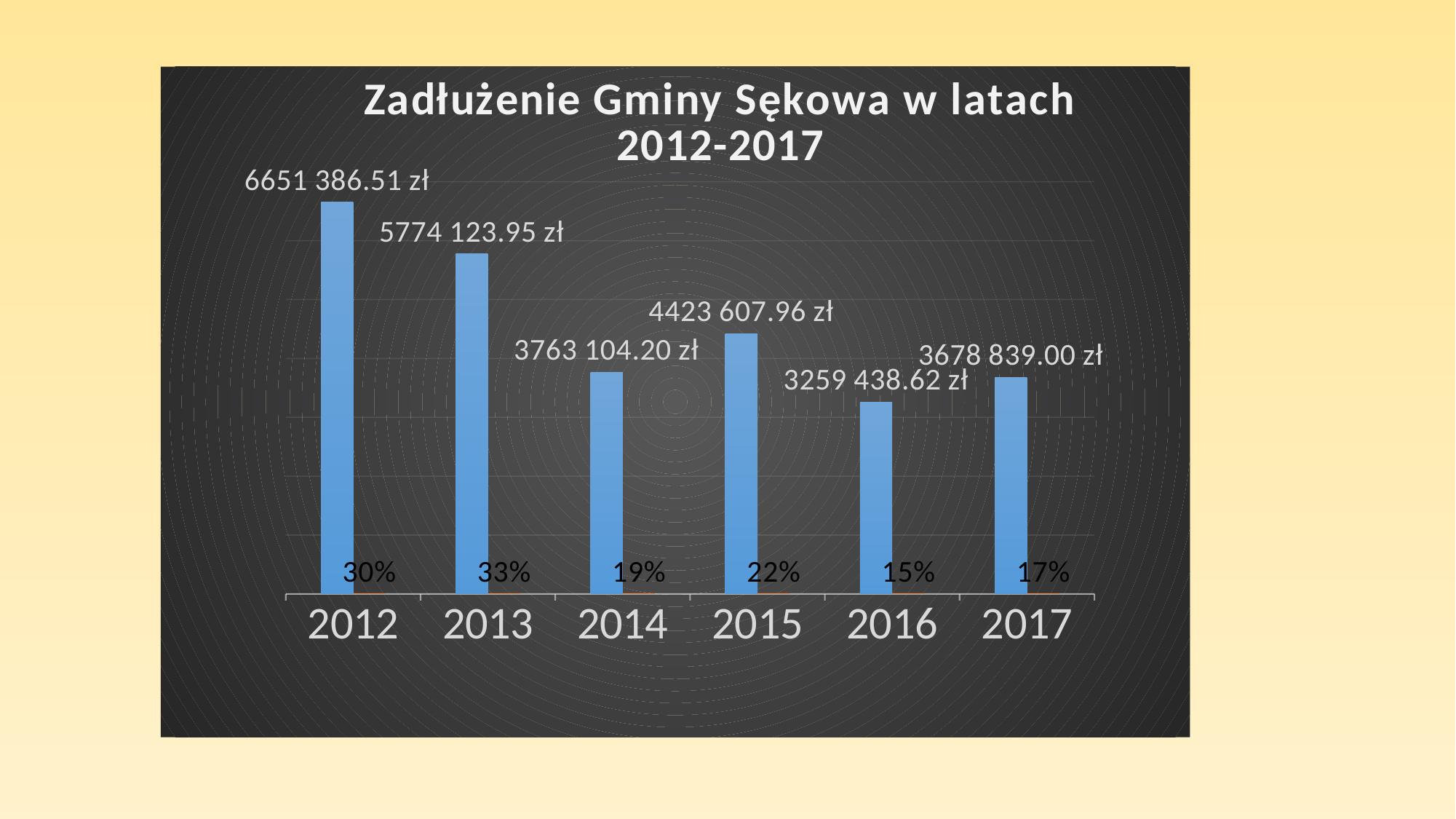
How many years are shown on the x axis? 6 What is the debt value shown for 2017? 3678 839.00 zł What kind of chart is shown on the slide? Bar chart Which year has a larger debt value, 2014 or 2015? 2015 What is the debt value shown for 2016? 3259 438.62 zł What is the difference between the debt values for 2017 and 2016? 419 400.38 zł What percentage is shown at the base of the 2013 bar? 33% What is the difference between the debt values for 2012 and 2013? 877 262.56 zł What is the debt value shown for 2012? 6651 386.51 zł Which year has the highest debt value? 2012 What is the title of the chart? Zadłużenie Gminy Sękowa w latach 2012-2017 Which year has the lowest debt value? 2016